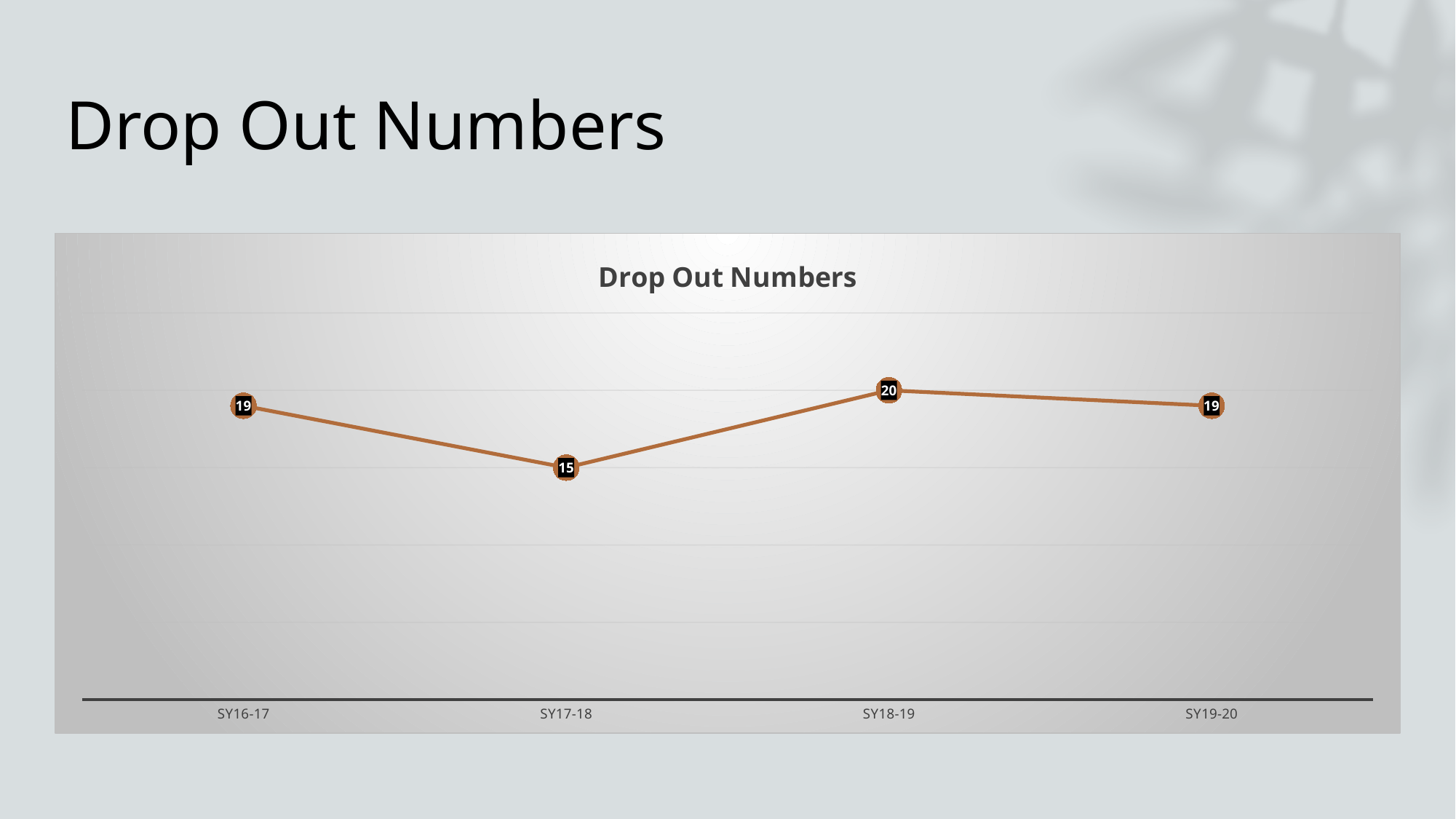
Which school year has the highest drop out number? SY18-19 What is the difference between the drop out numbers for SY18-19 and SY17-18? 5 What is the drop out number for SY17-18? 15 What is the drop out number for SY19-20? 19 How many school years are plotted on the chart? 4 What is the difference between the drop out numbers for SY16-17 and SY17-18? 4 What is the drop out number for SY18-19? 20 Which school year has the lowest drop out number? SY17-18 What kind of chart is shown on the slide? Line chart Which is larger, the drop out number for SY17-18 or for SY19-20? SY19-20 What is the title of the chart? Drop Out Numbers What is the drop out number for SY16-17? 19